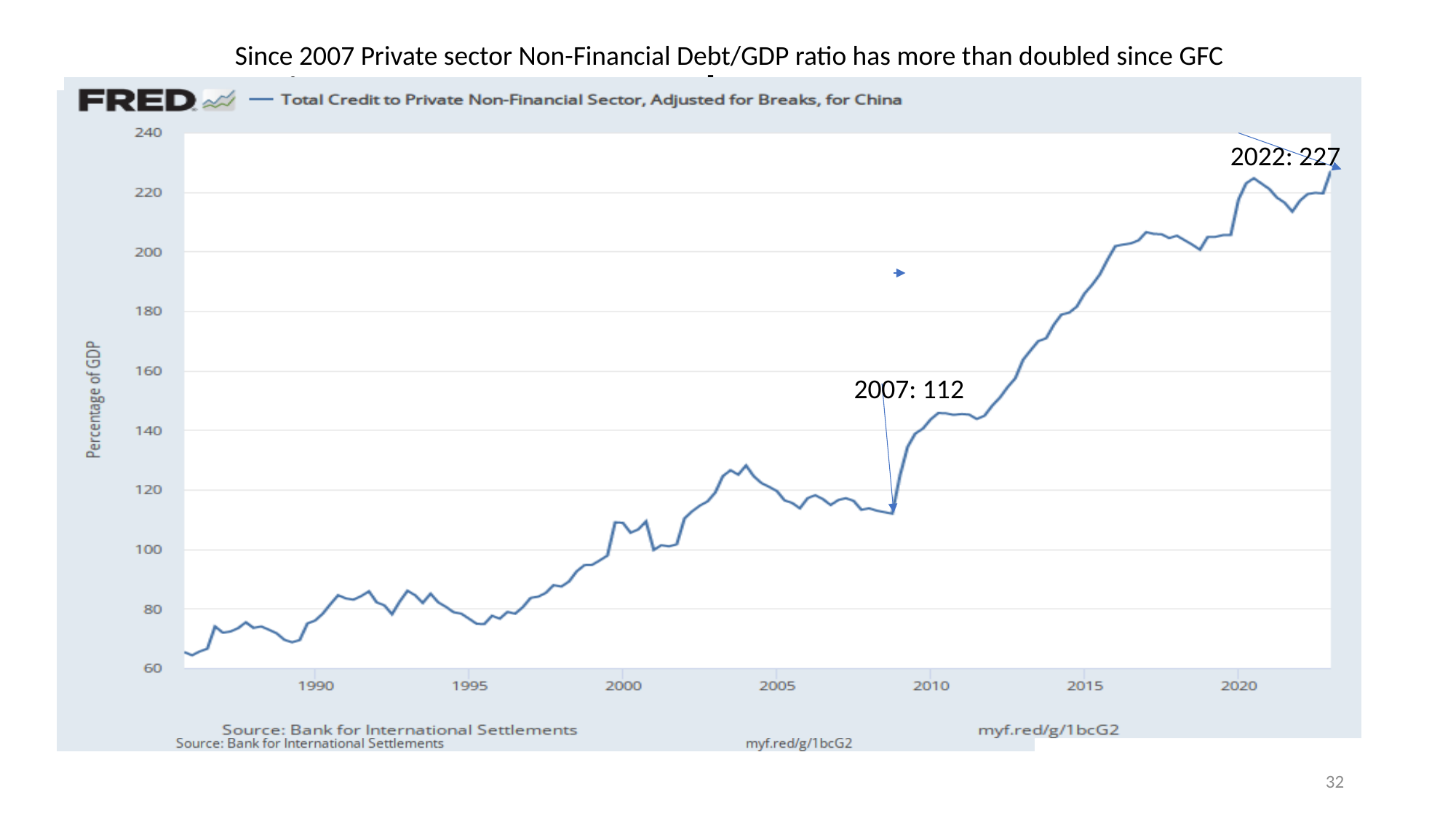
What source is cited below the chart? Bank for International Settlements What kind of chart is shown on the slide? line chart What is the label on the vertical axis of the chart? Percentage of GDP Is the value for 2020 greater or less than 200? greater What value is annotated for 2022 on the chart? 227 What is the difference between the annotated 2022 value and the annotated 2007 value? 115 Is the value for 1990 greater or less than 100? less What value is annotated for 2007 on the chart? 112 How many series does the chart legend list? 1 Which annotated value is larger, 2007 or 2022? 2022 Is the value for 2005 greater or less than 140? less Overall, does the series rise or fall from the start of the chart to the end? rise